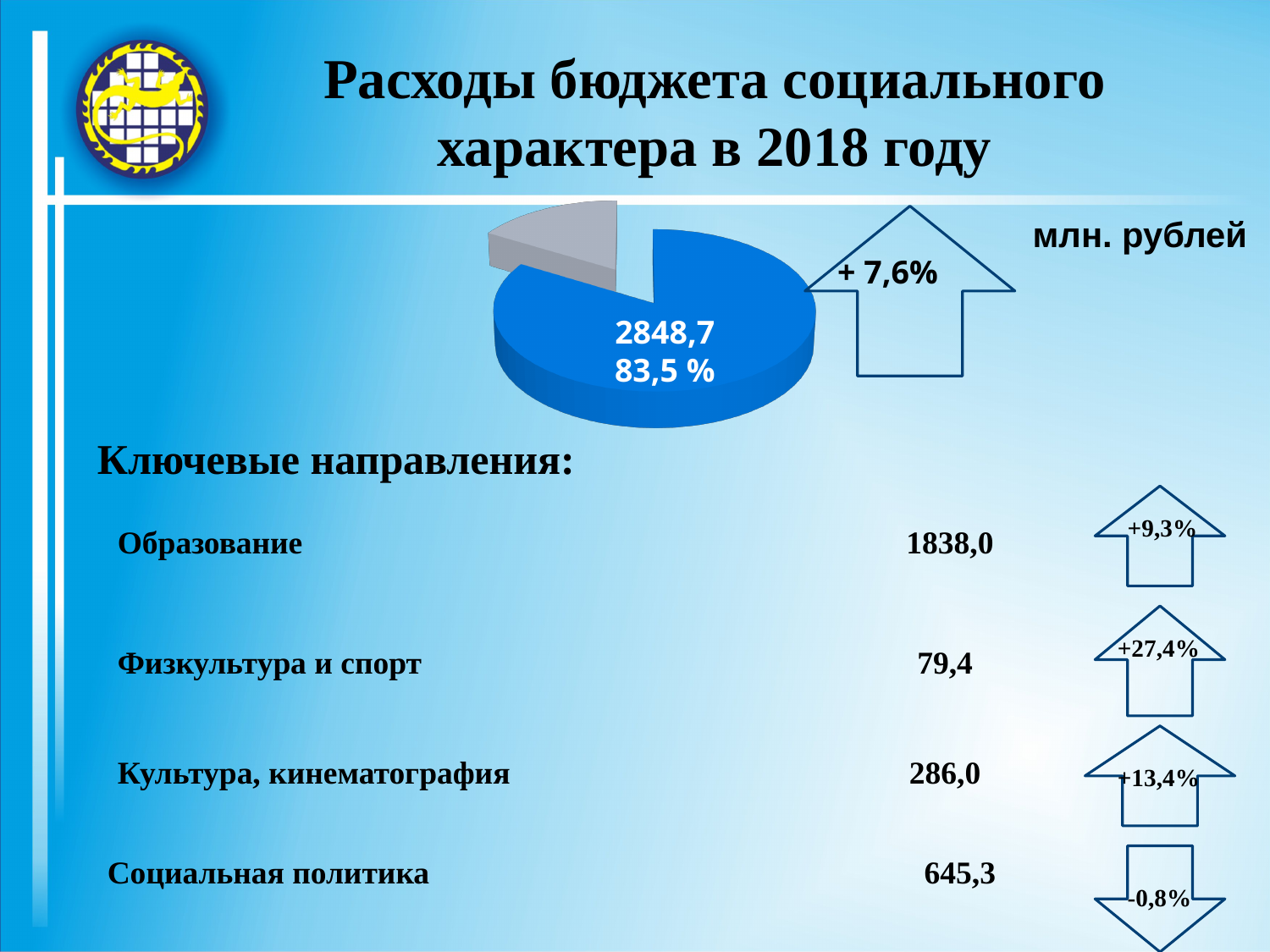
What value is printed on the blue slice of the pie chart? 2848,7 What unit is indicated next to the pie chart? млн. рублей What share of the pie does the blue slice represent, as printed on the chart? 83,5 % Which slice of the pie chart is the smallest? the grey slice Which slice is larger in the pie chart, the blue one or the grey one? the blue one How many slices does the pie chart have? 2 What is the title of the slide containing the pie chart? Расходы бюджета социального характера в 2018 году What kind of chart is shown on the slide? pie chart Which slice of the pie chart is the largest? the blue slice